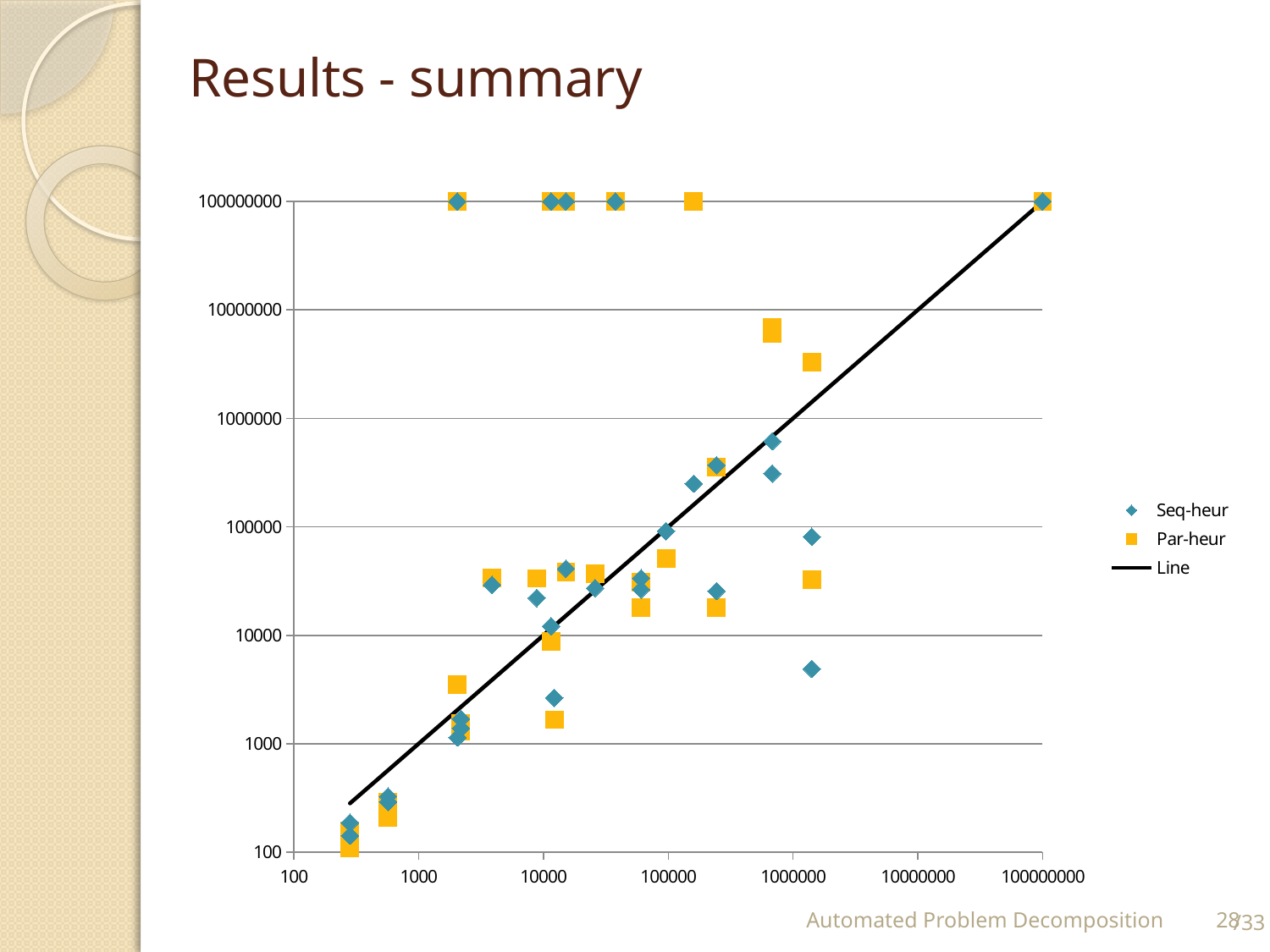
Do the plotted values generally rise or fall as the x-axis value increases? rise Is the Par-heur point near x = 2000 that lies above the line greater or less than 1000 on the y axis? greater What are the names of the series listed in the legend? Seq-heur, Par-heur, Line What is the title of the slide containing the chart? Results - summary Is the highest Par-heur point near x = 1000000 greater or less than 1000000 on the y axis? greater Are the Seq-heur points near x = 100 greater or less than 1000 on the y axis? less What kind of chart is shown on the slide? scatter chart How many series does the legend list? 3 What is the lowest value shown on the x axis? 100 Which series is plotted with orange square markers? Par-heur What is the highest value shown on the y axis? 100000000